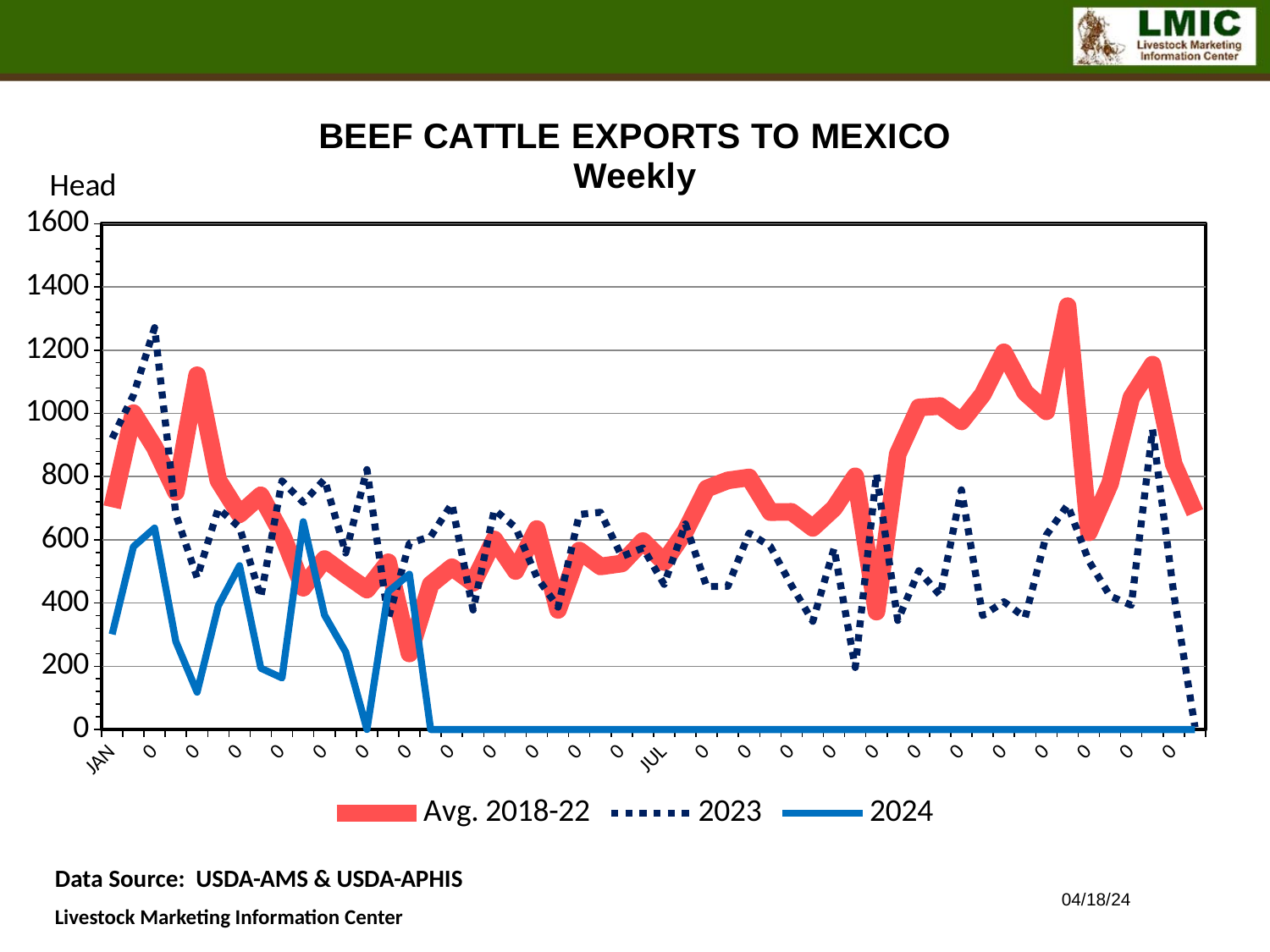
Is the 2024 value at JUL greater or less than 200? less Does the Avg. 2018-22 series generally rise or fall from JAN to JUL? fall What kind of chart is shown on the slide? line chart How many series does the legend list? 3 What unit is shown on the y axis of the chart? Head At JAN, which series has the higher value, 2023 or 2024? 2023 Is the Avg. 2018-22 value at JUL greater or less than 400? greater What is the title of the chart? BEEF CATTLE EXPORTS TO MEXICO Weekly Is the highest value of the 2024 series greater or less than 800? less Which series has the lowest peak value on the chart? 2024